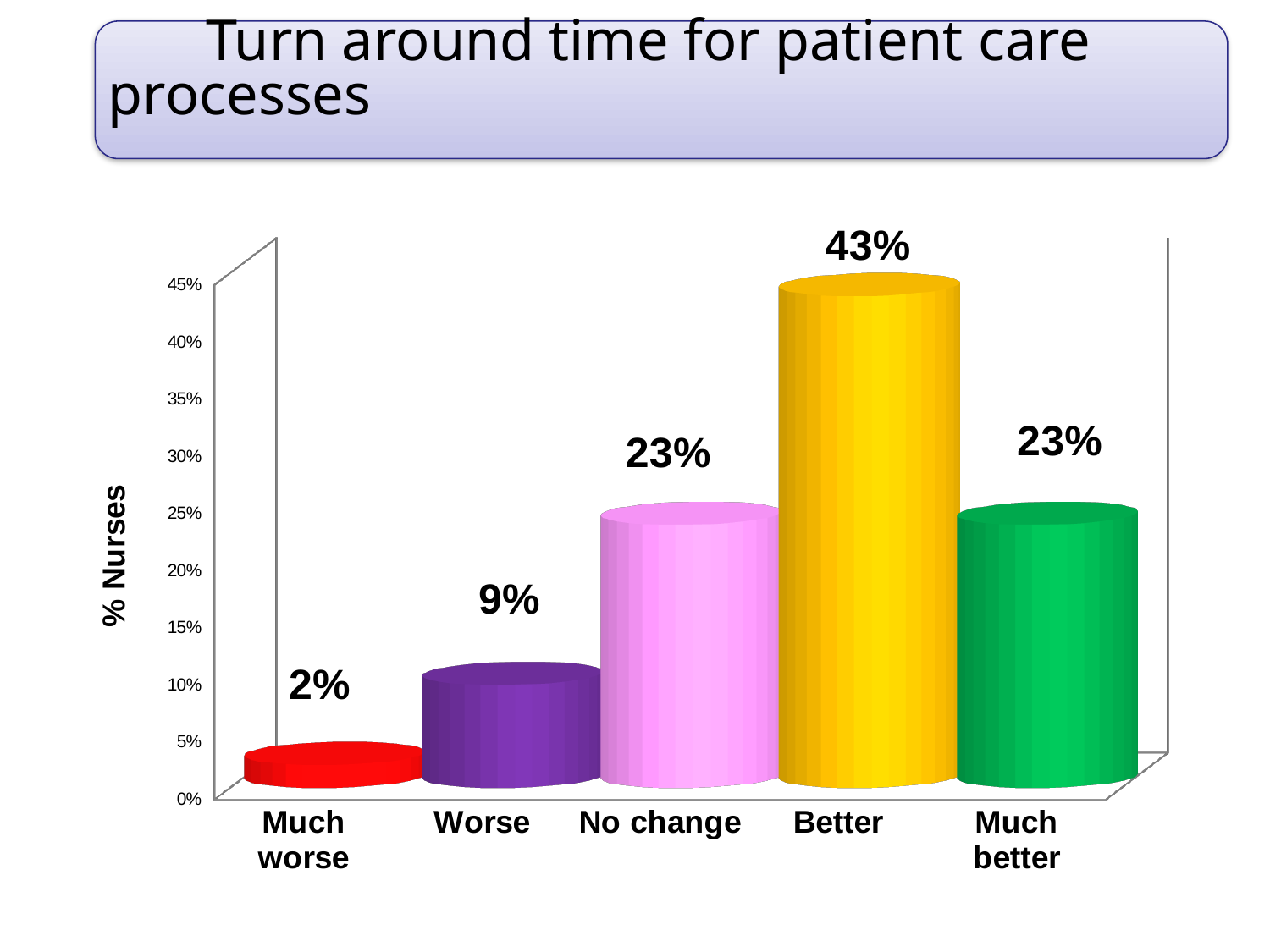
What percentage of nurses answered "Much worse"? 2% Which response category has the lowest percentage of nurses? Much worse Which has a larger percentage of nurses, "Worse" or "No change"? No change How many response categories are shown on the x axis? 5 Which response category has the highest percentage of nurses? Better What percentage of nurses answered "No change"? 23% What percentage of nurses answered "Worse"? 9% What is the difference in percentage points between "Worse" and "Much worse"? 7 What is the difference in percentage points between "Better" and "Much better"? 20 What percentage of nurses answered "Better"? 43% What is the label of the vertical axis? % Nurses What kind of chart is shown on the slide? Bar chart